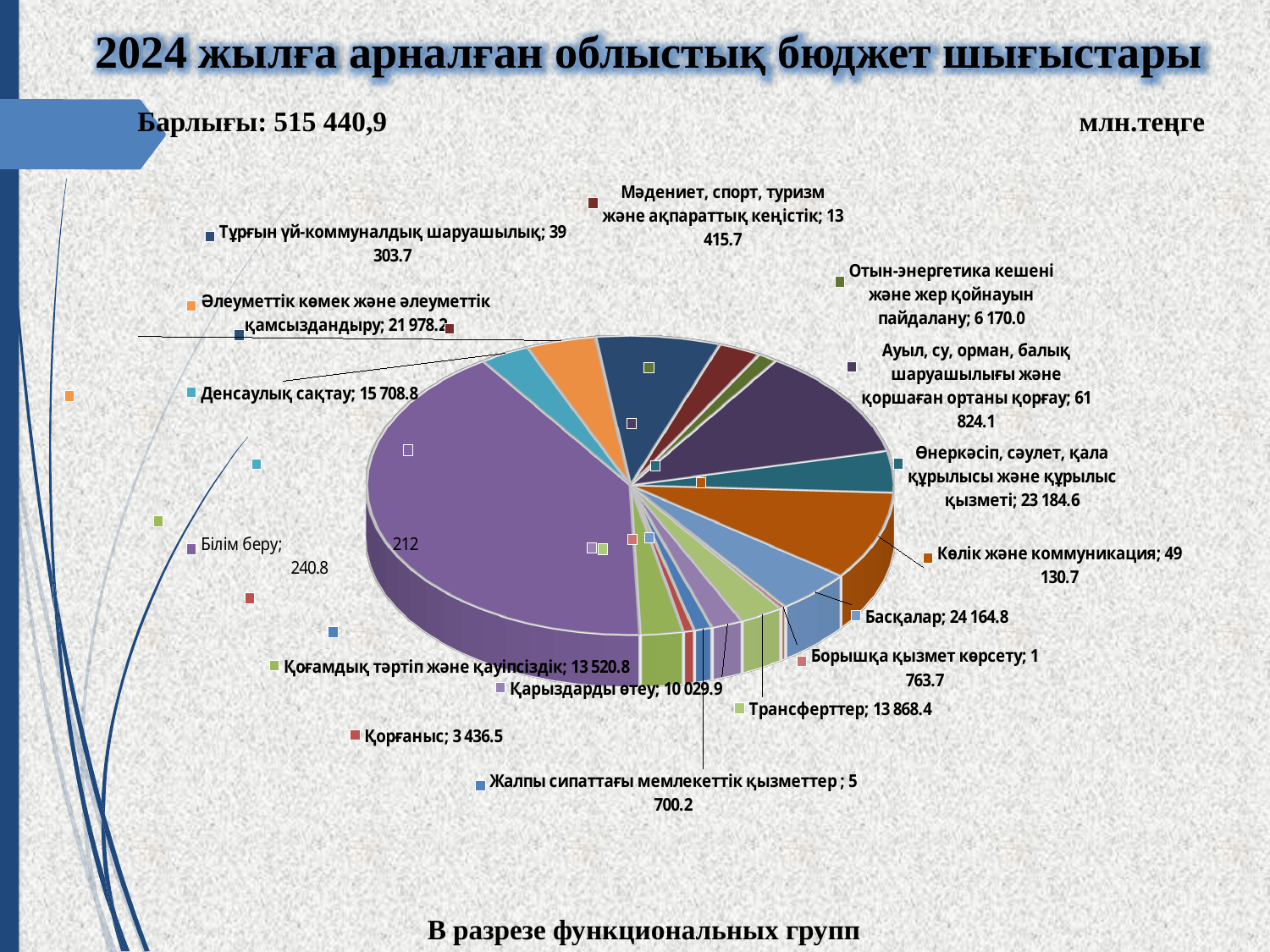
What is the value for Денсаулық сақтау? 15 708.8 What is the value for Ауыл, су, орман, балық шаруашылығы және қоршаған ортаны қорғау? 61 824.1 What kind of chart is shown on the slide? Pie chart How many categories are shown in the pie chart? 16 What is the value for Борышқа қызмет көрсету? 1 763.7 What is the difference between Көлік және коммуникация and Тұрғын үй-коммуналдық шаруашылық? 9 827.0 Which category has the largest value in the pie chart? Білім беру What is the value for Білім беру? 212 240.8 Which is larger: Өнеркәсіп, сәулет, қала құрылысы және құрылыс қызметі or Басқалар? Басқалар What total amount (Барлығы) is stated on the slide? 515 440,9 млн.теңге Which category has the smallest value in the pie chart? Борышқа қызмет көрсету What is the value for Көлік және коммуникация? 49 130.7